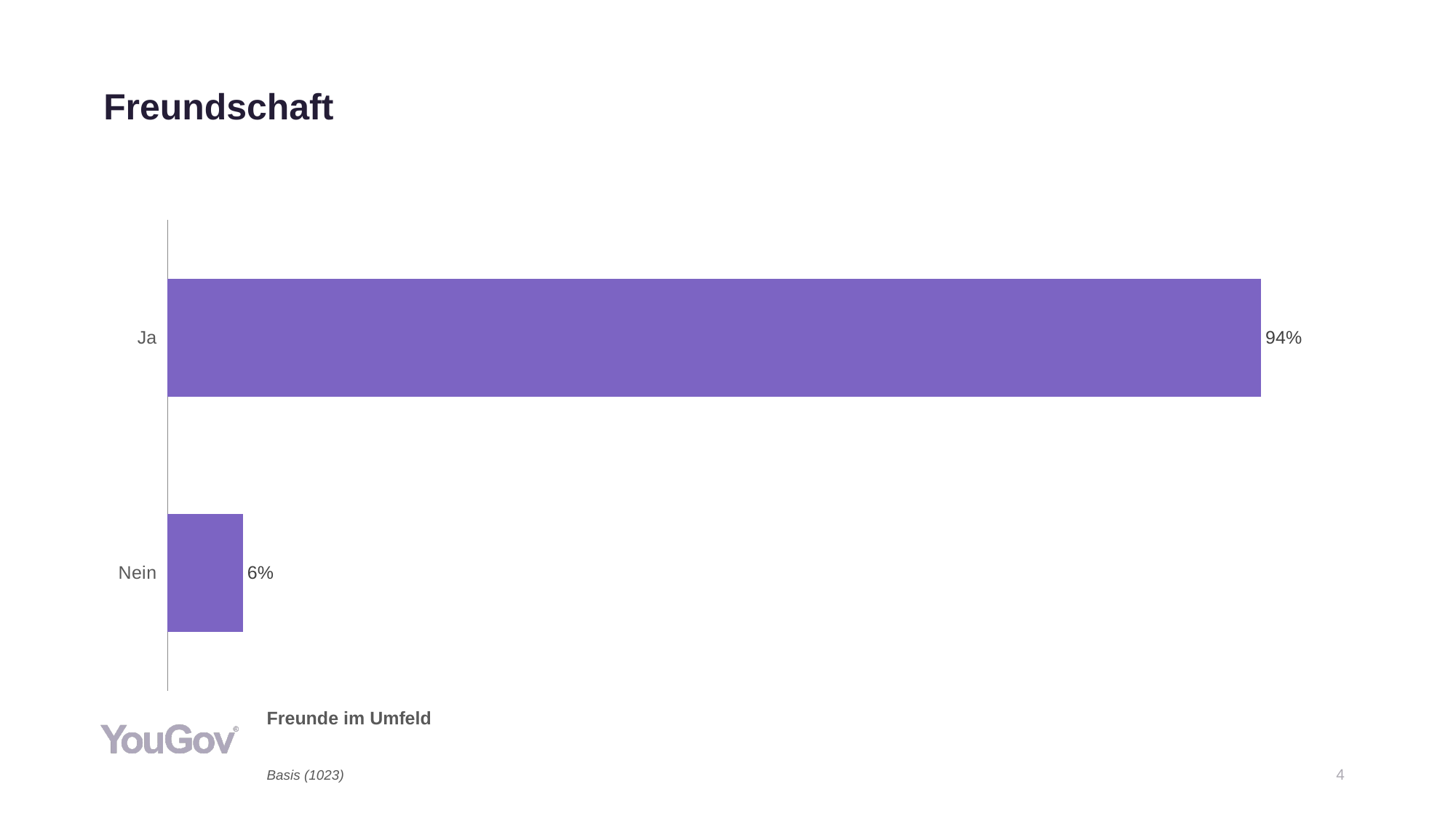
Which category has the lowest value? Nein What is the value for Nein? 6% What is the title of the slide? Freundschaft How many categories are shown in the chart? 2 What is the base (Basis) stated below the chart? 1023 What is the difference between the values for Ja and Nein? 88% What is the value for Ja? 94% Which category has the highest value? Ja What kind of chart is shown on the slide? Bar chart Which is larger, the value for Ja or the value for Nein? Ja What is the total of the values for Ja and Nein? 100%